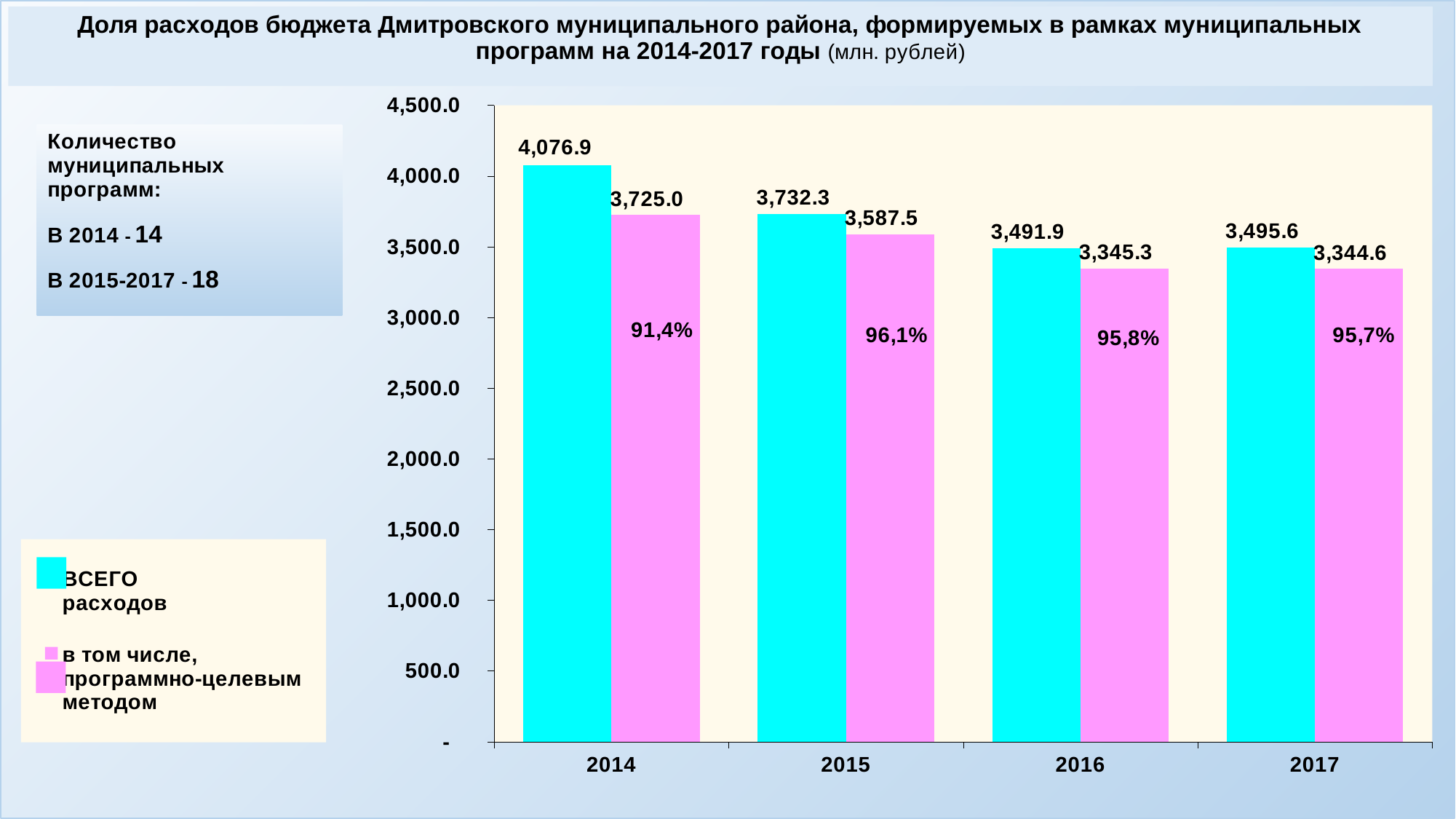
In which year is the программно-целевым методом value the highest? 2014 How many series does the legend list? 2 What is the value of ВСЕГО расходов for 2016? 3,491.9 How many years are shown on the x axis? 4 What is the value of ВСЕГО расходов for 2014? 4,076.9 What is the difference between ВСЕГО расходов and the программно-целевым методом value in 2014? 351.9 What is the value of the программно-целевым методом series for 2017? 3,344.6 What is the value of the программно-целевым методом series for 2015? 3,587.5 Is the программно-целевым методом value for 2016 greater or less than 3,500.0? less What percentage label is shown on the 2015 программно-целевым методом bar? 96,1% Which is larger: ВСЕГО расходов in 2014 or in 2015? 2014 In which year is ВСЕГО расходов the highest? 2014